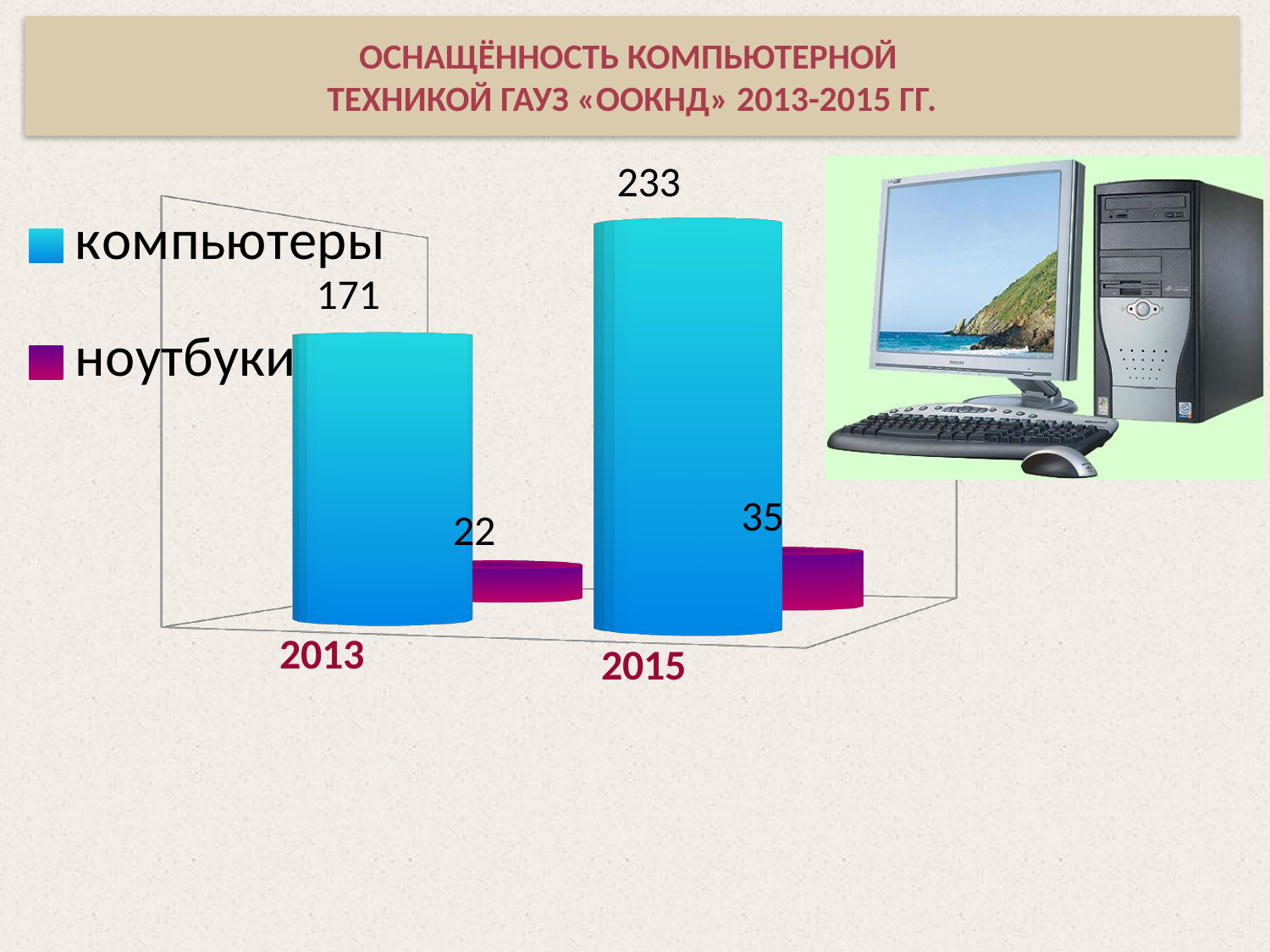
How many computers (компьютеры) were there in 2013? 171 Which year had more computers (компьютеры), 2013 or 2015? 2015 Which series has the higher value in 2015, компьютеры or ноутбуки? компьютеры How many computers (компьютеры) were there in 2015? 233 By how much did the number of laptops (ноутбуки) increase from 2013 to 2015? 13 By how much did the number of computers (компьютеры) increase from 2013 to 2015? 62 Do the values for компьютеры rise or fall from 2013 to 2015? rise How many years (categories) are shown on the x axis? 2 How many series does the legend list? 2 How many laptops (ноутбуки) were there in 2013? 22 What kind of chart is shown on the slide? bar chart How many laptops (ноутбуки) were there in 2015? 35